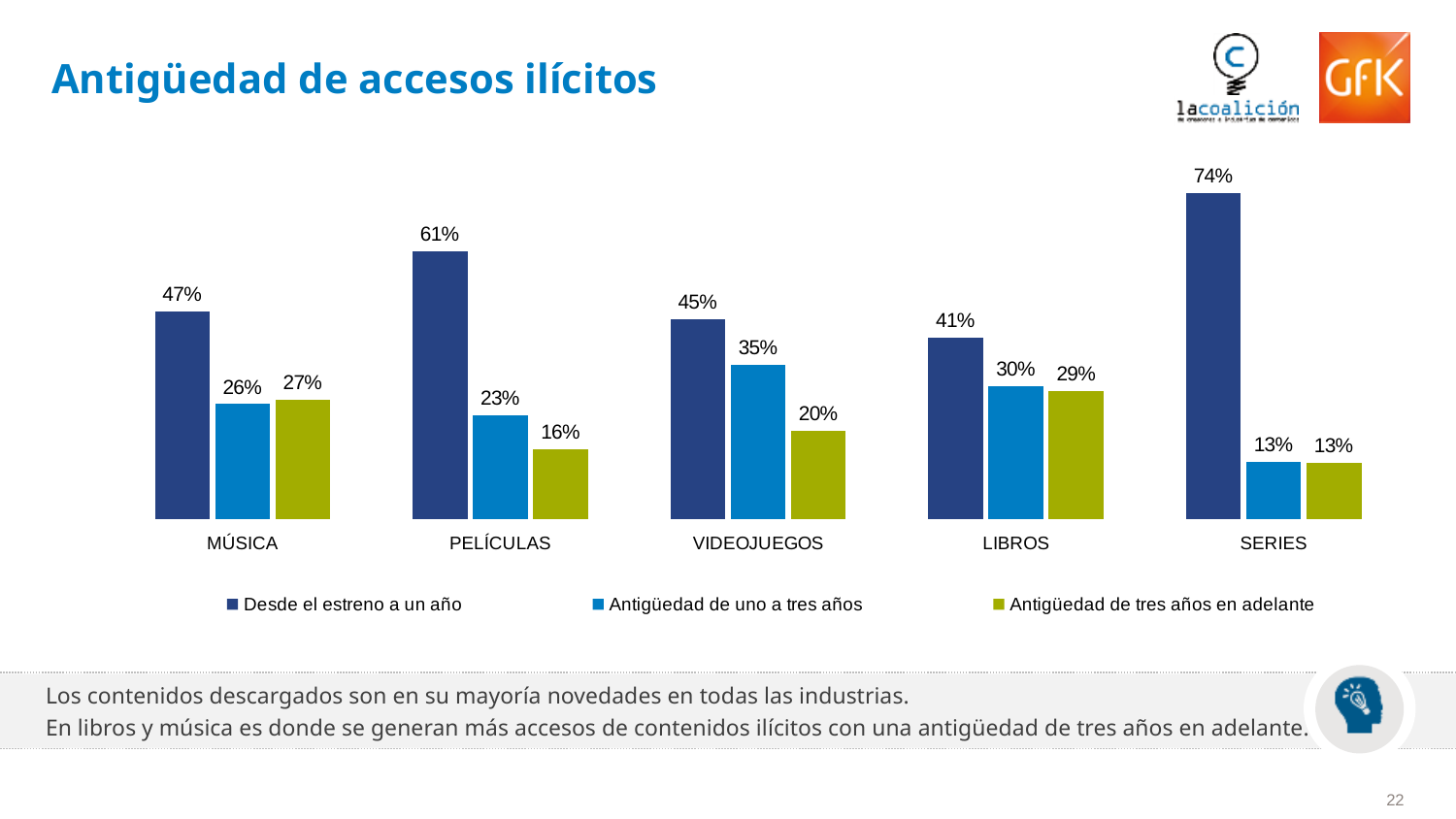
Which category has the lowest value for "Antigüedad de tres años en adelante"? SERIES How many series does the legend list? 3 Which is larger: the "Antigüedad de uno a tres años" value for LIBROS or for PELÍCULAS? LIBROS Which category has the highest value for "Desde el estreno a un año"? SERIES What is the value for "Desde el estreno a un año" in the SERIES category? 74% What kind of chart is shown on the slide? Bar chart What is the value for "Antigüedad de uno a tres años" in the VIDEOJUEGOS category? 35% How many categories are shown on the x axis? 5 What is the title of the slide? Antigüedad de accesos ilícitos What is the difference between the "Desde el estreno a un año" values for PELÍCULAS and MÚSICA? 14 percentage points Which legend entry is shown in green? Antigüedad de tres años en adelante What is the value for "Antigüedad de tres años en adelante" in the PELÍCULAS category? 16%